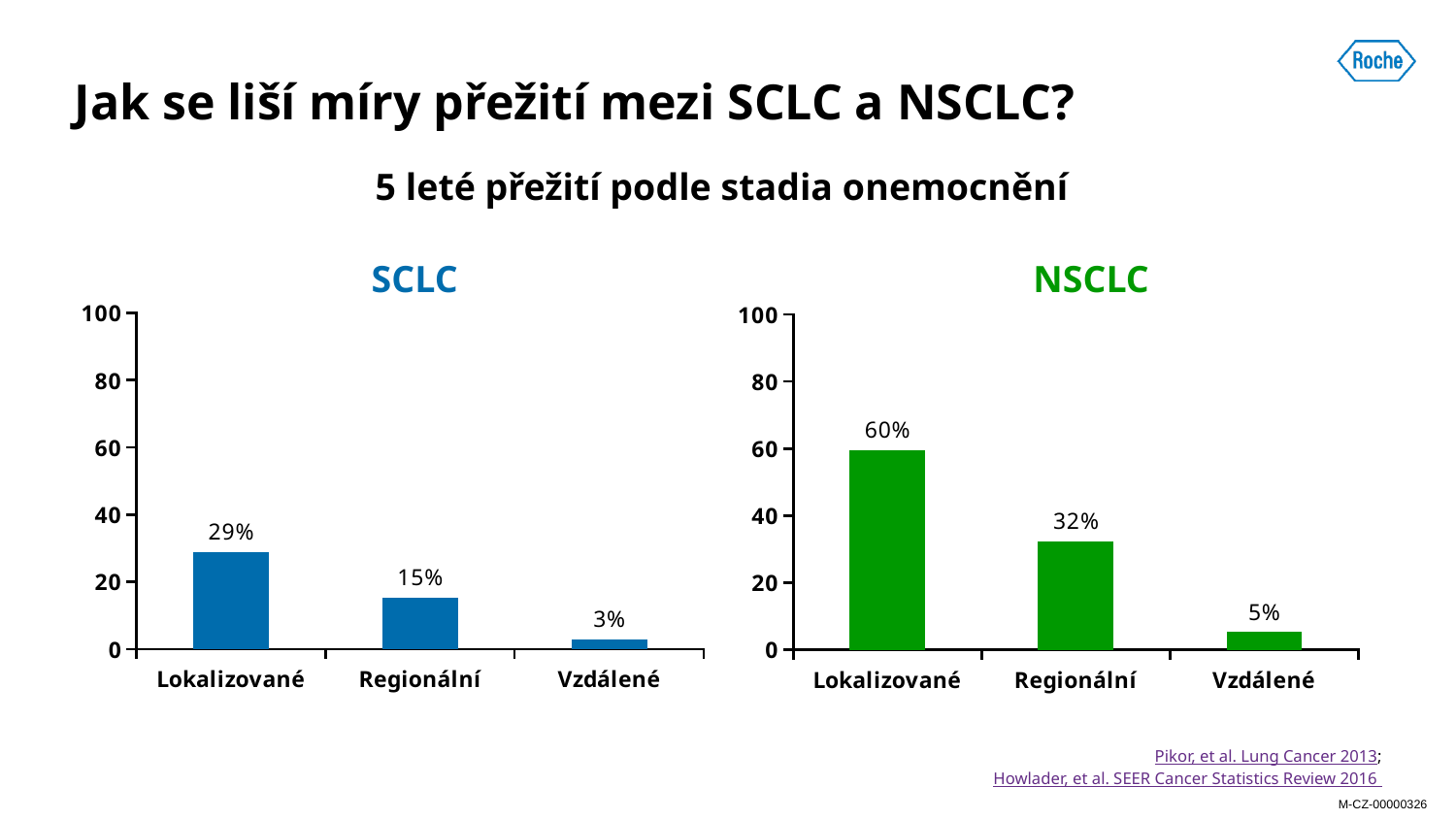
Which is larger: the Regionální value in the SCLC chart or the Regionální value in the NSCLC chart? NSCLC In the NSCLC chart, what is the value for Regionální? 32% In the SCLC chart, which category has the lowest value? Vzdálené How many categories are shown in the NSCLC chart? 3 In the NSCLC chart, what is the difference between the values for Lokalizované and Regionální? 28% In the SCLC chart, is the value for Lokalizované greater or less than 40? less In the SCLC chart, what is the value for Lokalizované? 29% In the NSCLC chart, which category has the highest value? Lokalizované In the SCLC chart, what is the value for Vzdálené? 3% What kind of chart is the SCLC chart? bar chart In the NSCLC chart, do the values rise or fall from Lokalizované to Vzdálené? fall What colour are the bars in the NSCLC chart? green